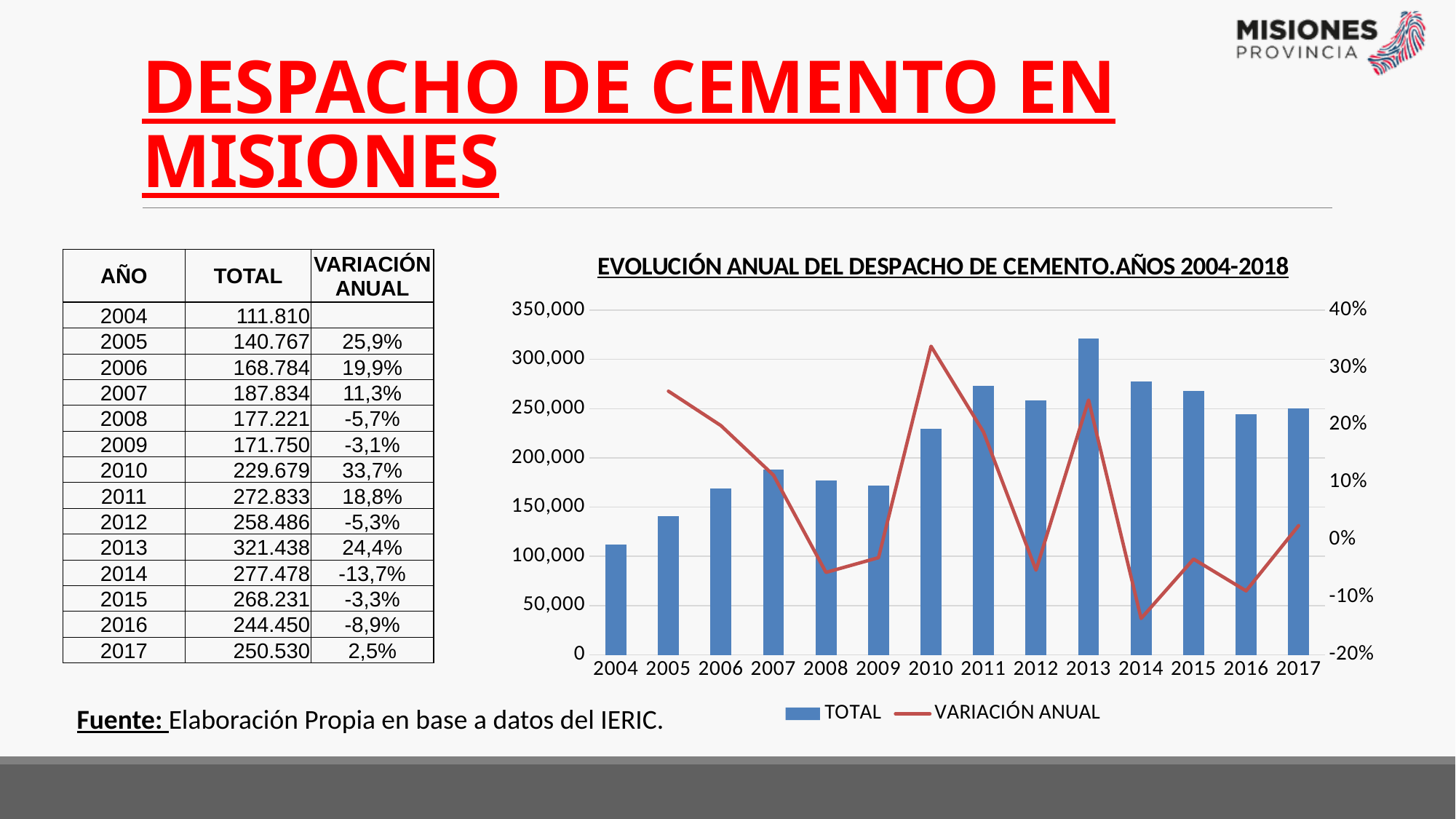
According to the table on the slide, what is the TOTAL for 2013? 321.438 Which year has the lowest VARIACIÓN ANUAL value on the line? 2014 Which year has the highest TOTAL bar in the chart? 2013 According to the table on the slide, what is the VARIACIÓN ANUAL for 2010? 33,7% What is the title of the chart? EVOLUCIÓN ANUAL DEL DESPACHO DE CEMENTO.AÑOS 2004-2018 Is the TOTAL bar for 2010 greater or less than 200,000? greater Is the TOTAL bar for 2008 greater or less than 200,000? less What kind of chart is shown on the slide? bar chart with a line Which year has the lowest TOTAL bar in the chart? 2004 Using the table values, what is the difference between the TOTAL for 2013 and the TOTAL for 2012? 62.952 How many years are plotted on the x axis of the chart? 14 How many series does the chart legend list? 2